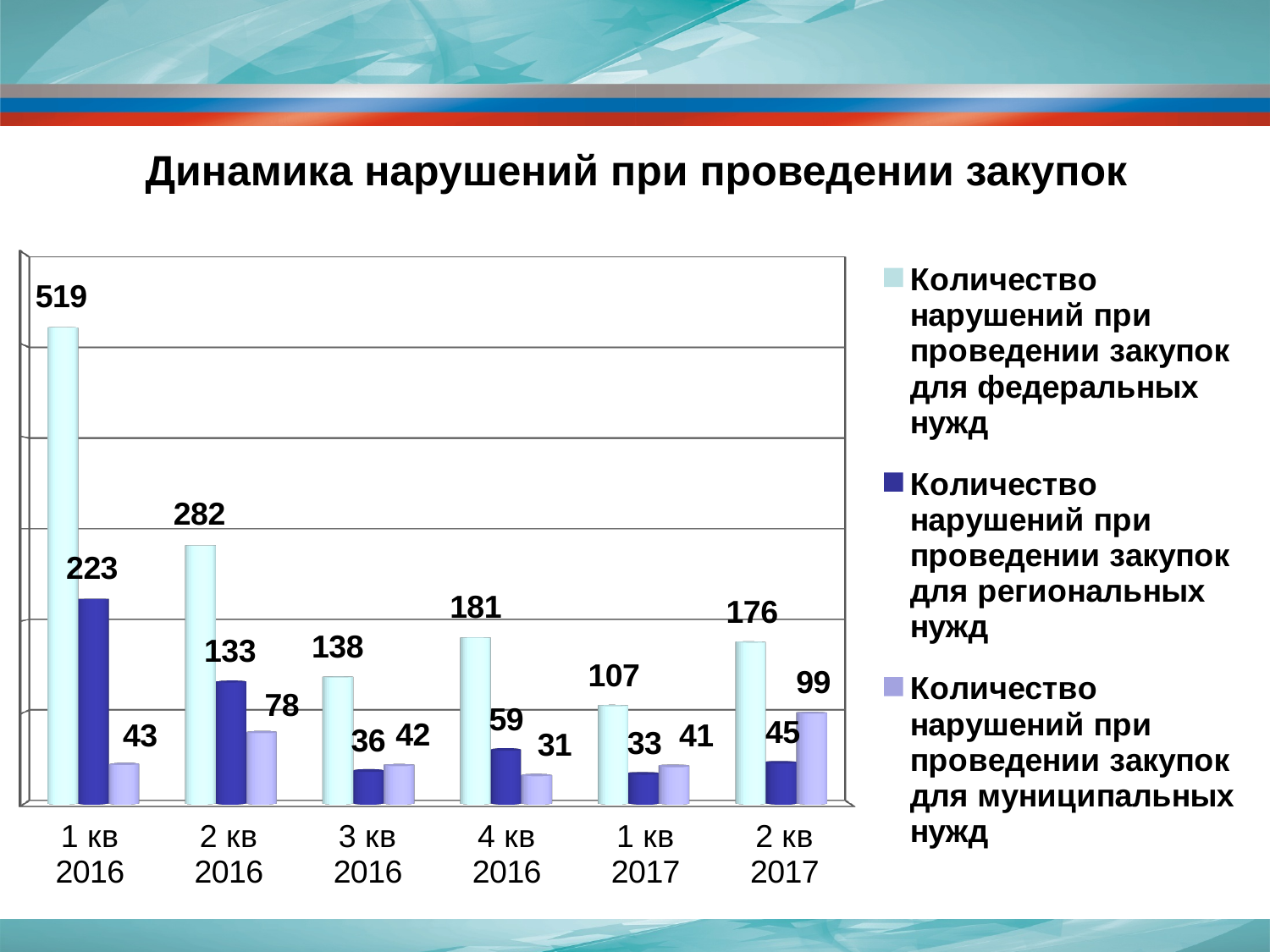
What is the title of the slide? Динамика нарушений при проведении закупок What is the number of violations in procurement for regional needs in 4 кв 2016? 59 Does the number of violations for federal needs rise or fall from 1 кв 2016 to 3 кв 2016? Fall What is the number of violations in procurement for municipal needs in 2 кв 2017? 99 How many series does the legend list? 3 In which quarter is the number of violations for municipal needs the lowest? 4 кв 2016 How many quarters are shown on the x axis? 6 What kind of chart is shown on the slide? Bar chart What is the difference between the federal and regional violation counts in 2 кв 2016? 149 In which quarter is the number of violations for federal needs the highest? 1 кв 2016 What is the number of violations in procurement for federal needs in 1 кв 2016? 519 Which is larger in 3 кв 2016: violations for regional needs or for municipal needs? Municipal needs (42)